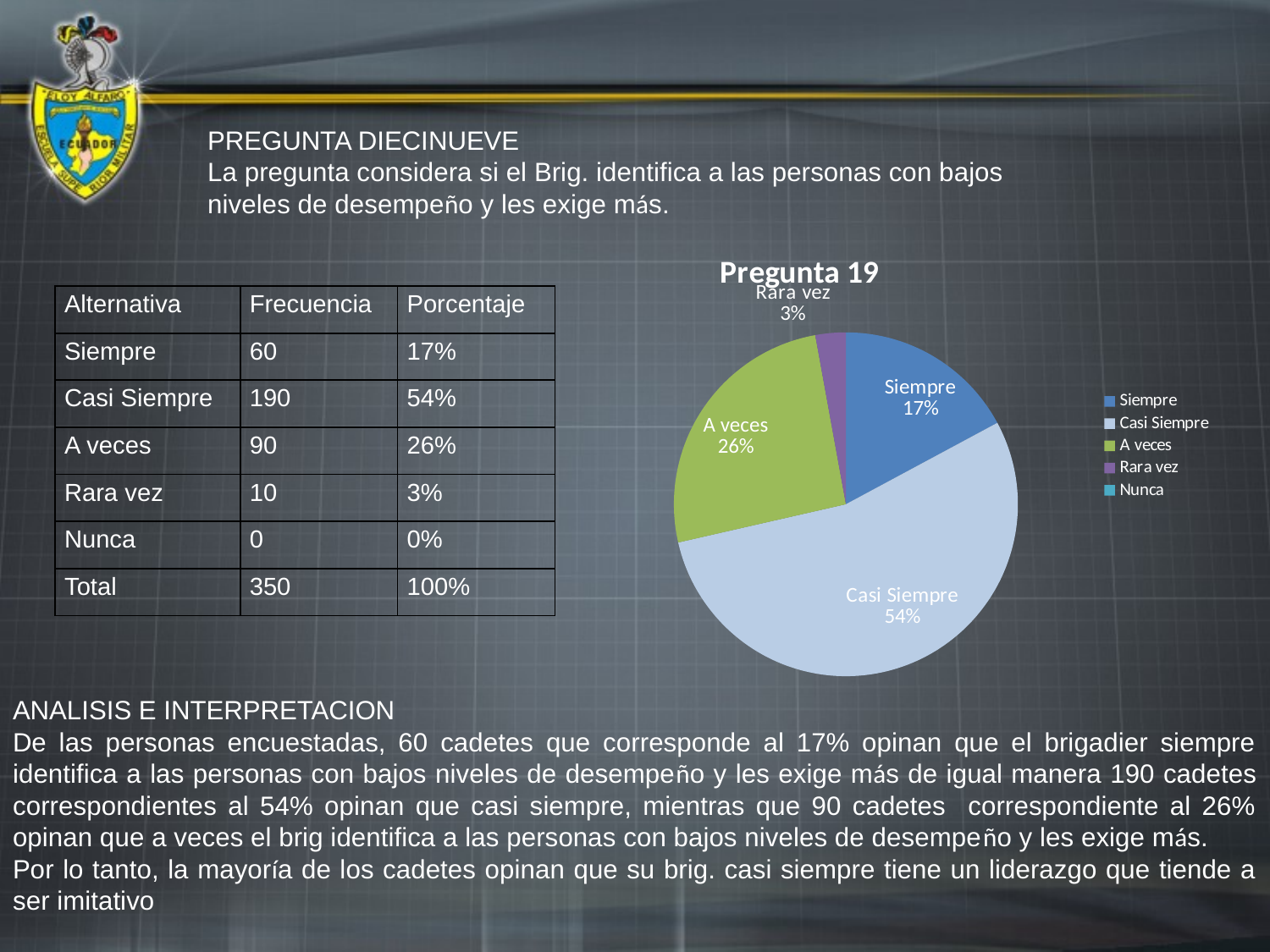
What percentage does the Siempre slice show in the pie chart? 17% Which slice is larger in the pie chart, Siempre or A veces? A veces Which labelled slice in the pie chart is the smallest? Rara vez What type of chart is shown on the slide? pie chart What is the title of the chart? Pregunta 19 What colour is the Casi Siempre slice in the pie chart? light blue How many entries does the legend of the pie chart list? 5 What percentage does the A veces slice show in the pie chart? 26% What percentage does the Rara vez slice show in the pie chart? 3% What is the difference in percentage points between the Casi Siempre and A veces slices? 28% What percentage does the Casi Siempre slice show in the pie chart? 54% Which category has the largest slice in the pie chart? Casi Siempre